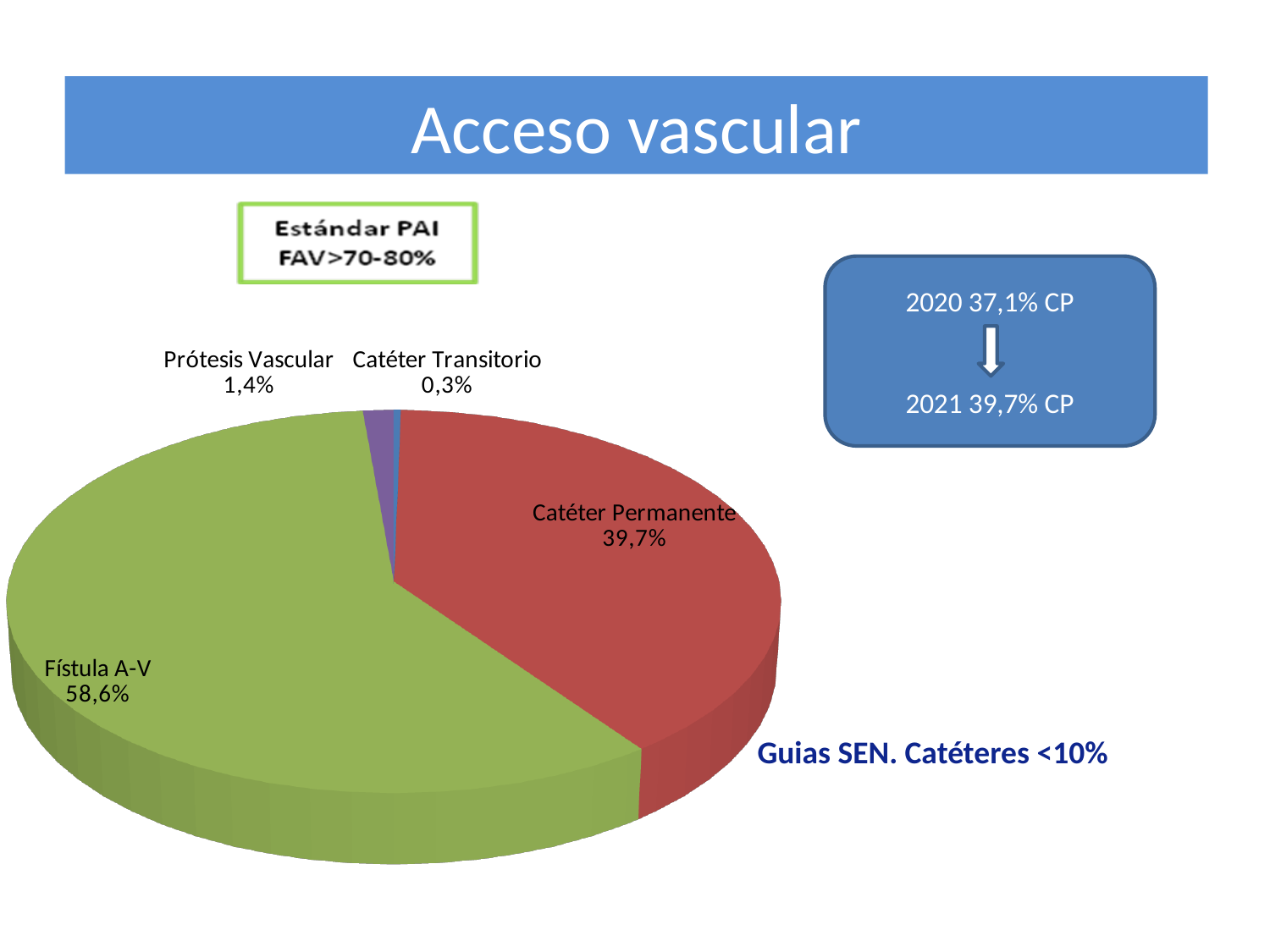
What is the title of the slide containing the chart? Acceso vascular What percentage of the pie does Catéter Permanente represent? 39,7% How many categories are shown in the pie chart? 4 What colour is the Catéter Permanente slice? Red What is the difference in percentage points between Fístula A-V and Catéter Permanente? 18,9 What kind of chart is shown on the slide? Pie chart What percentage of the pie does Catéter Transitorio represent? 0,3% Which category has the largest slice of the pie? Fístula A-V What percentage of the pie does Fístula A-V represent? 58,6% Which is larger, Prótesis Vascular or Catéter Transitorio? Prótesis Vascular What percentage of the pie does Prótesis Vascular represent? 1,4% Which category has the smallest slice of the pie? Catéter Transitorio